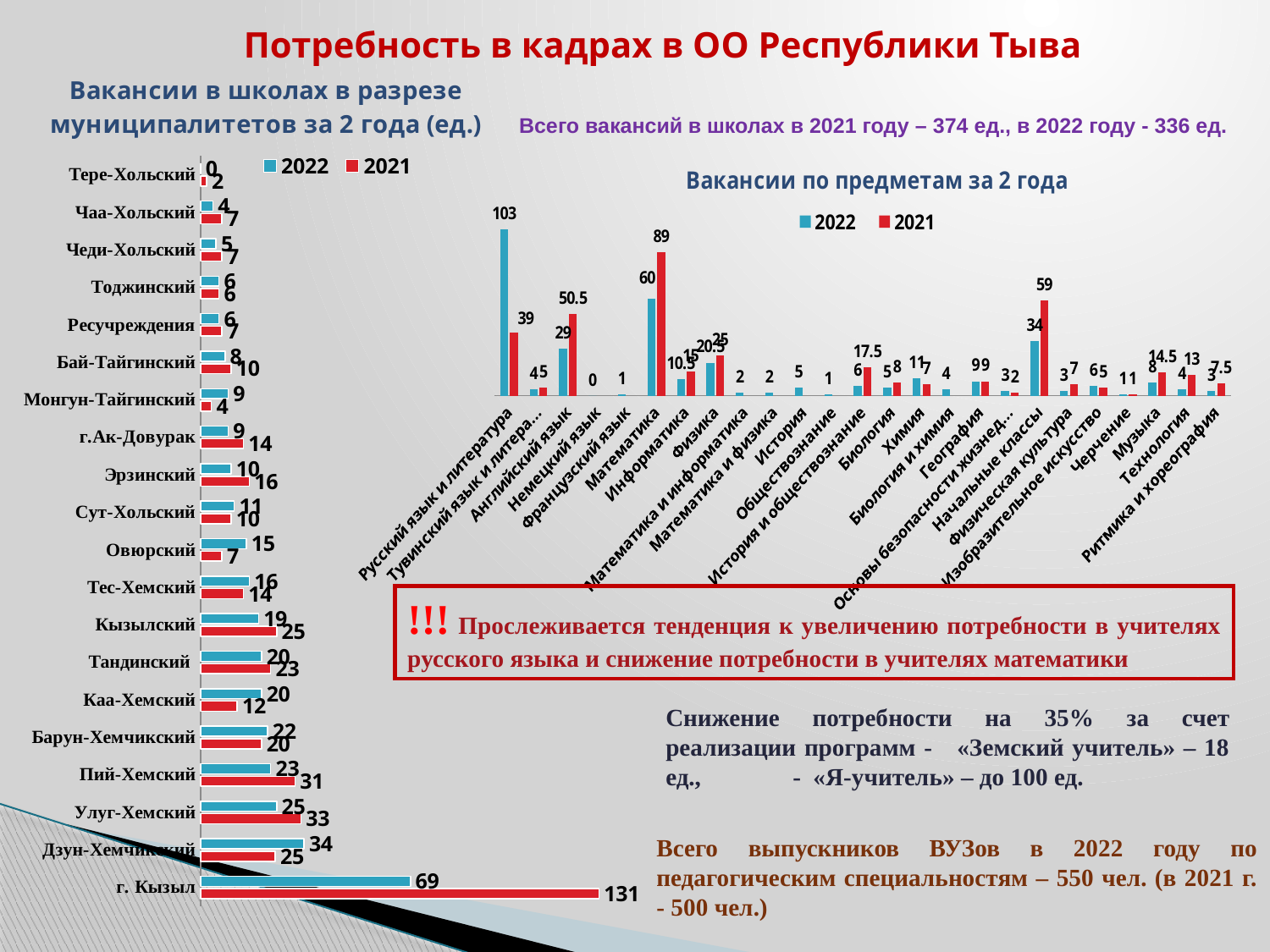
In the left chart 'Вакансии в школах в разрезе муниципалитетов за 2 года (ед.)', which municipality has the lowest 2022 value? Тере-Хольский In the right chart 'Вакансии по предметам за 2 года', which subject has the highest 2022 value? Русский язык и литература How many municipalities are shown in the left chart 'Вакансии в школах в разрезе муниципалитетов за 2 года (ед.)'? 20 In the chart 'Вакансии по предметам за 2 года' on the right, what is the 2021 value for Начальные классы? 59 In the chart 'Вакансии по предметам за 2 года' on the right, what is the 2022 value for Русский язык и литература? 103 How many series does the legend of the right chart 'Вакансии по предметам за 2 года' list? 2 In the chart 'Вакансии в школах в разрезе муниципалитетов за 2 года (ед.)' on the left, what is the 2022 value for г. Кызыл? 69 In the left chart 'Вакансии в школах в разрезе муниципалитетов за 2 года (ед.)', which municipality has the highest 2021 value? г. Кызыл In the left chart 'Вакансии в школах в разрезе муниципалитетов за 2 года (ед.)', is the 2022 value or the 2021 value larger for Дзун-Хемчикский? 2022 In the chart 'Вакансии в школах в разрезе муниципалитетов за 2 года (ед.)' on the left, what is the 2021 value for г. Кызыл? 131 In the left chart 'Вакансии в школах в разрезе муниципалитетов за 2 года (ед.)', what is the difference between the 2021 and 2022 values for г. Кызыл? 62 In the chart 'Вакансии по предметам за 2 года' on the right, what is the 2021 value for Математика? 89